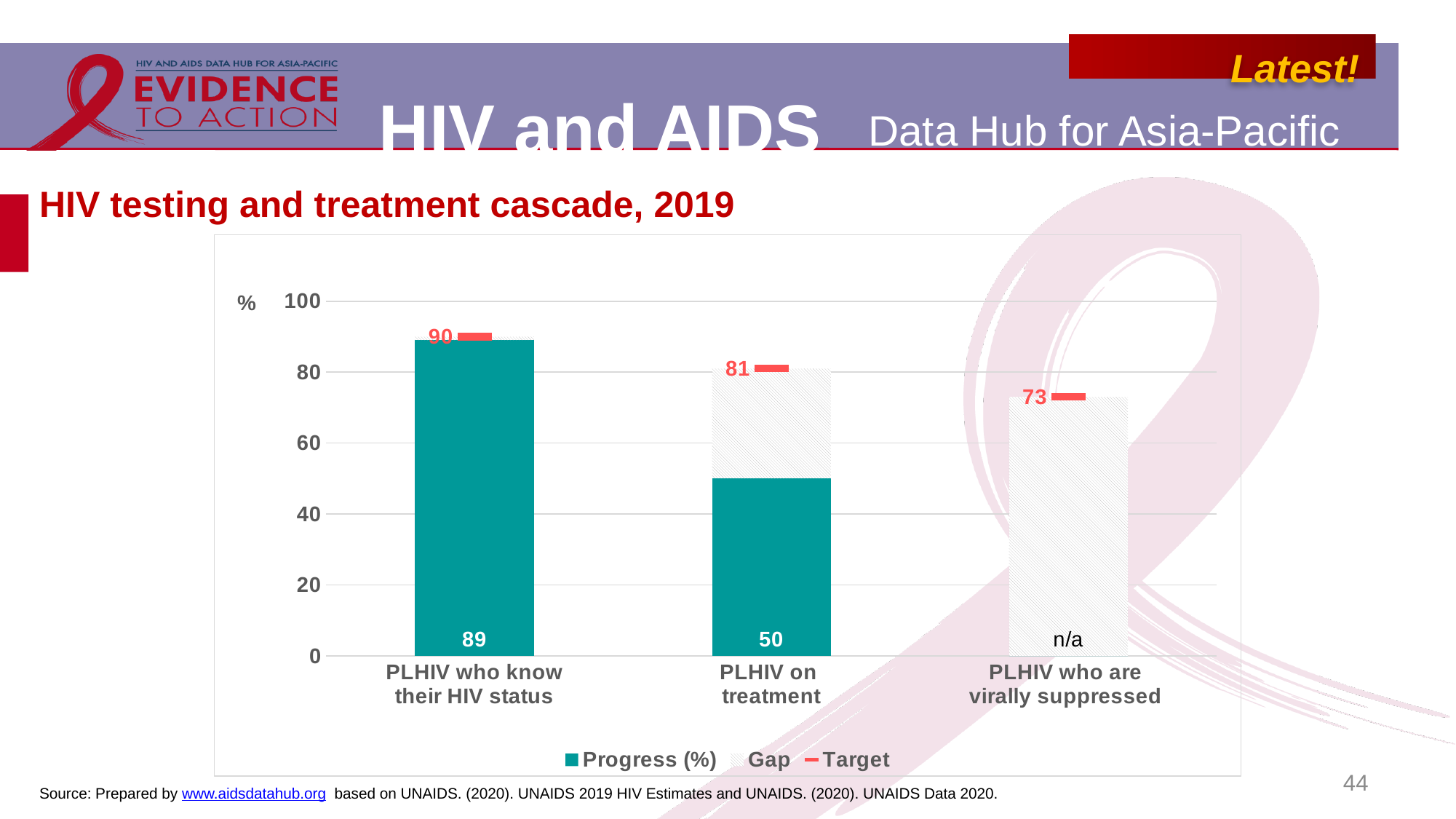
What is the difference between the Target and the Progress (%) for PLHIV on treatment? 31 Which category has the highest Target value? PLHIV who know their HIV status What is the Target value for PLHIV who know their HIV status? 90 What is the Target value for PLHIV on treatment? 81 How many categories are shown on the x axis of the chart? 3 How many series does the chart legend list? 3 What is the Progress (%) value for PLHIV who know their HIV status? 89 Which is larger, the Progress (%) for PLHIV who know their HIV status or for PLHIV on treatment? PLHIV who know their HIV status What is the Progress (%) value shown for PLHIV who are virally suppressed? n/a What is the Progress (%) value for PLHIV on treatment? 50 What is the Target value for PLHIV who are virally suppressed? 73 Which category has the lowest Target value? PLHIV who are virally suppressed